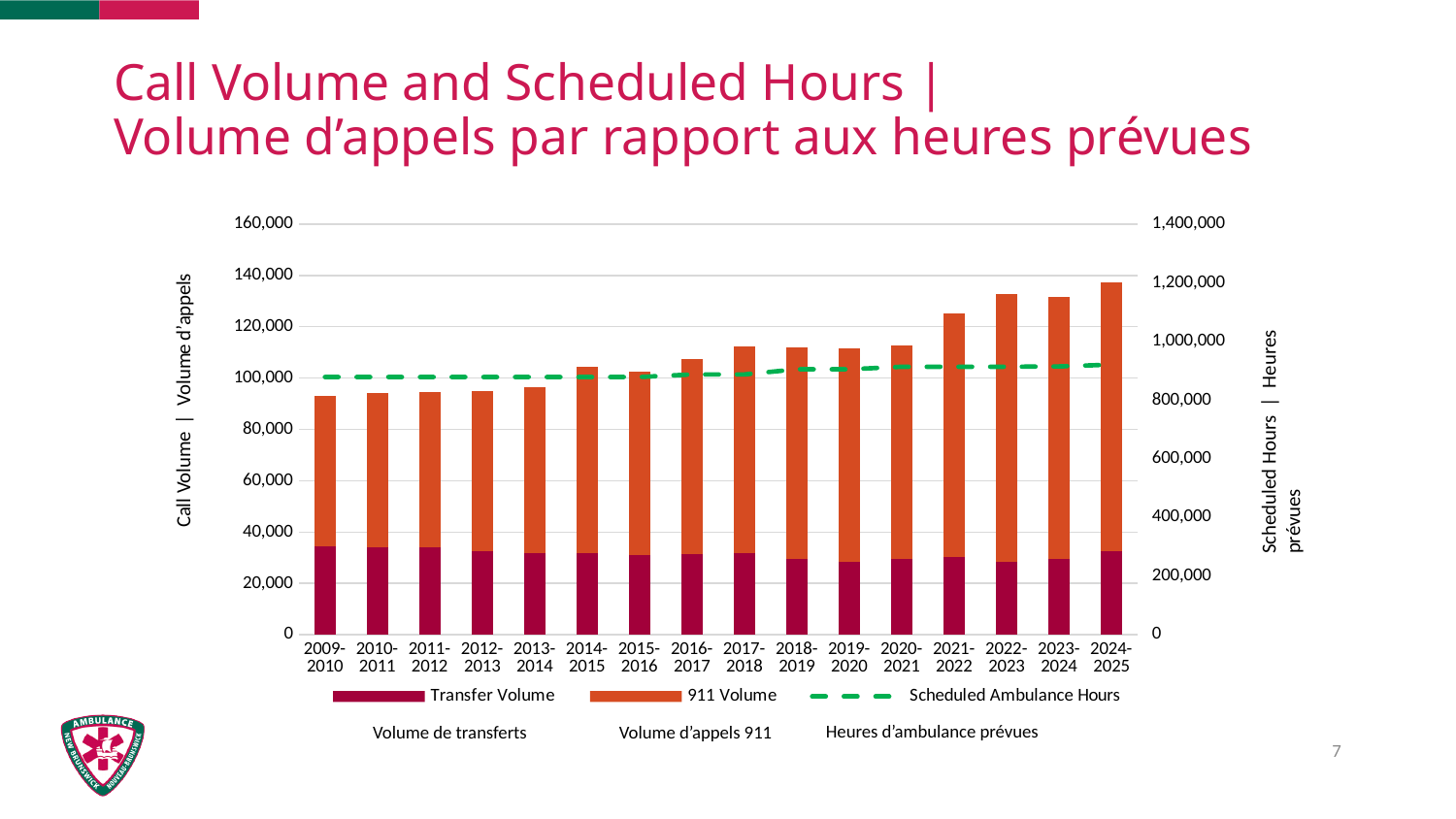
Is the total call volume for 2009-2010 greater or less than 100,000? less How many fiscal-year categories are shown on the x axis? 16 Which has the larger total call volume, 2021-2022 or 2022-2023? 2022-2023 Is the Transfer Volume for 2009-2010 greater or less than 40,000? less Which fiscal year has the highest total call volume bar? 2024-2025 How many series does the legend list? 3 What is the maximum value shown on the right-hand (Scheduled Hours) axis? 1,400,000 Which series is plotted as a dashed line? Scheduled Ambulance Hours Is the Scheduled Ambulance Hours value for 2024-2025 greater or less than 800,000? greater What kind of chart is shown on the slide? Stacked bar chart with a line Does the total call volume generally rise or fall from 2009-2010 to 2024-2025? rise